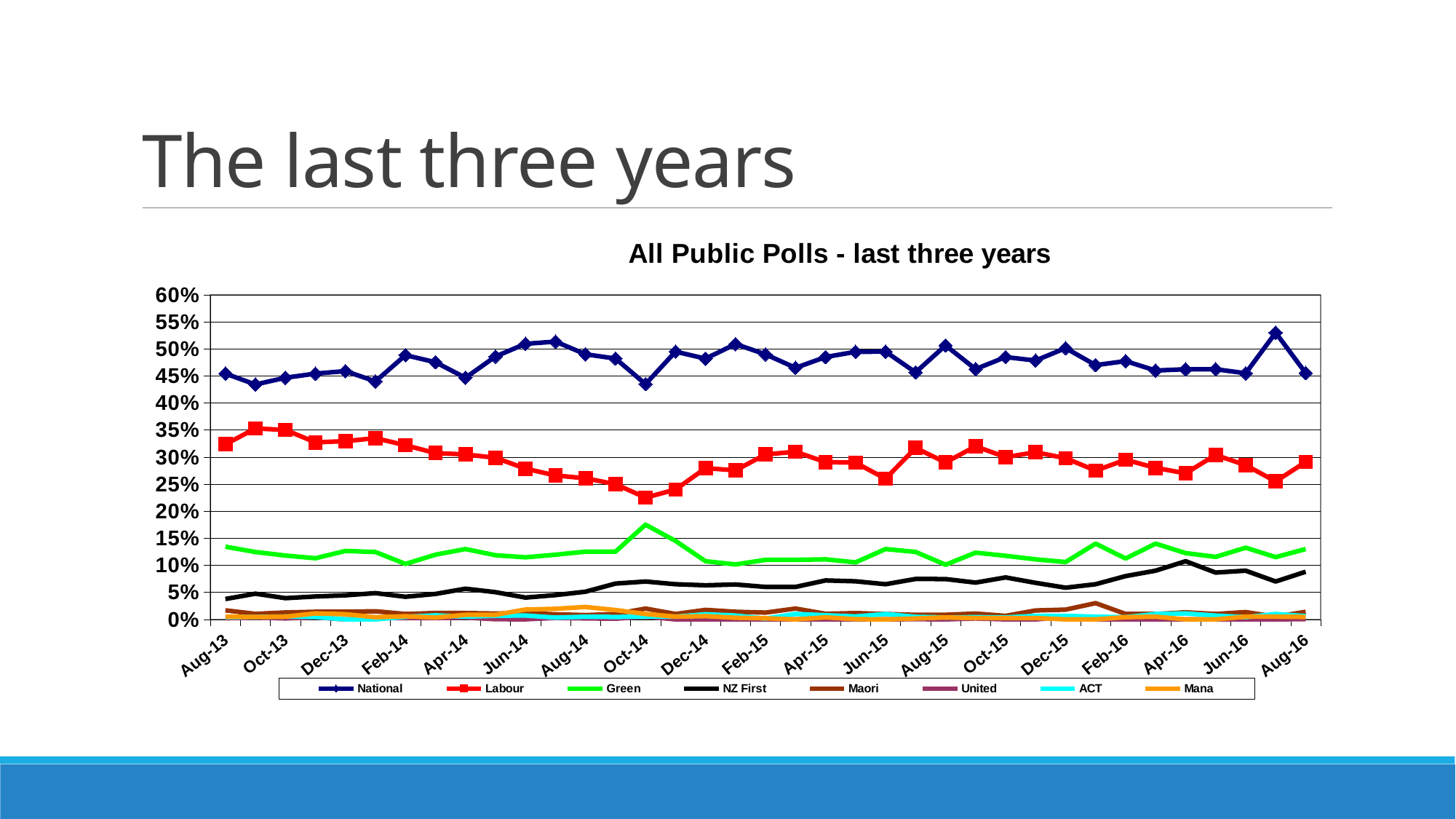
Is the value for Labour at Jun-15 greater or less than 30%? less Which is larger at Aug-16, the value for National or the value for Labour? National How many date labels are shown on the x axis? 19 Is the value for Green at Oct-14 greater or less than 15%? greater What kind of chart is shown on the slide? Line chart Is the value for Labour at Oct-14 greater or less than 25%? less Which is larger at Aug-16, the value for Green or the value for NZ First? Green What is the title of the chart? All Public Polls - last three years Which series has the highest values across the whole chart? National Does the Labour line rise or fall between Aug-13 and Oct-14? Fall How many series does the legend list? 8